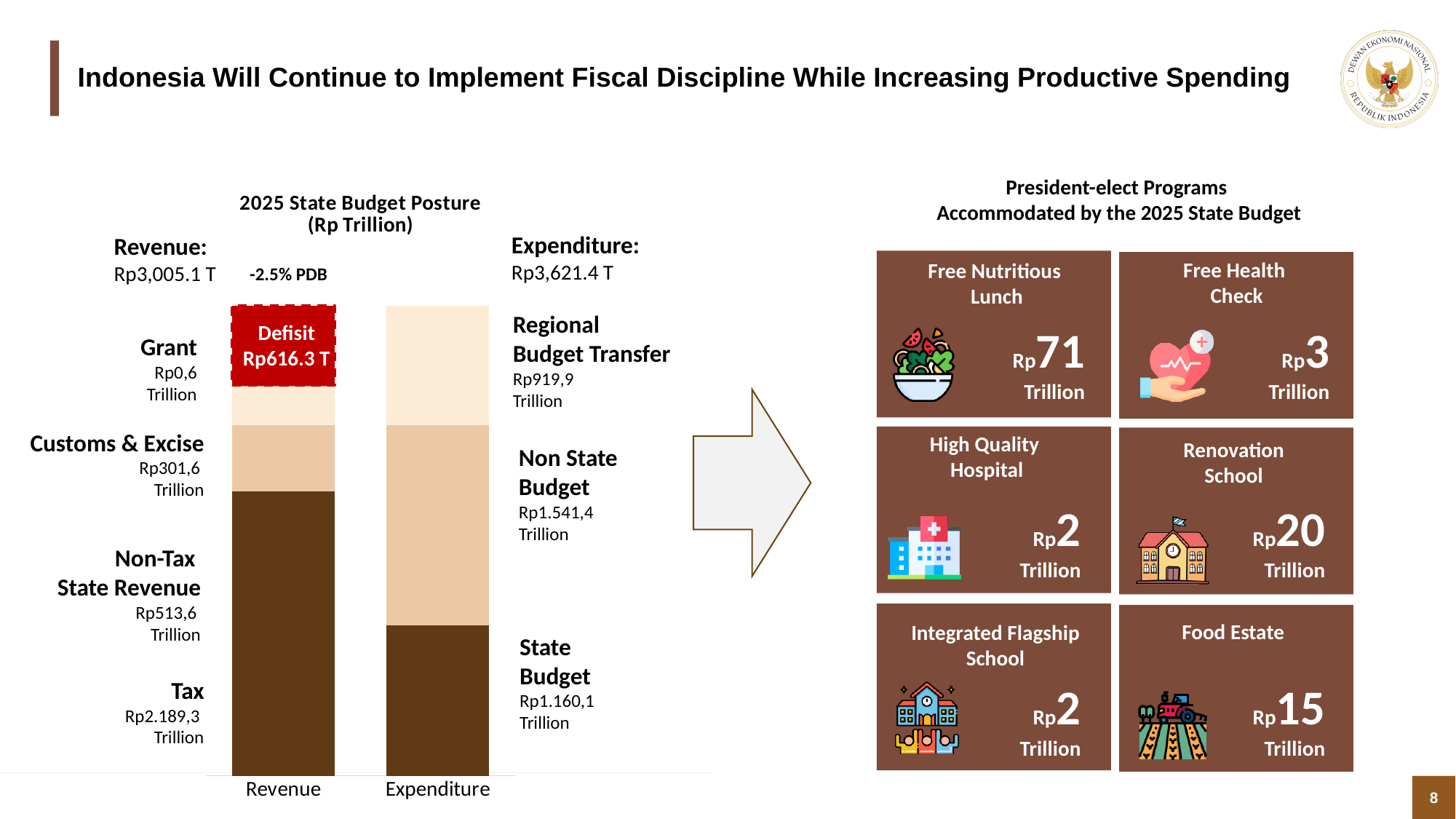
In the 2025 State Budget Posture chart, what is the total of the Expenditure bar? Rp3,621.4 T What kind of chart is the 2025 State Budget Posture chart? Stacked bar chart In the 2025 State Budget Posture chart, which segment of the Revenue bar is the smallest? Grant In the 2025 State Budget Posture chart, what is the value of the Non State Budget segment of the Expenditure bar? Rp1.541,4 Trillion How many bars are shown in the 2025 State Budget Posture chart? 2 In the 2025 State Budget Posture chart, which segment of the Revenue bar is the largest? Tax In the 2025 State Budget Posture chart, what is the value of the Customs & Excise segment? Rp301,6 Trillion In the 2025 State Budget Posture chart, what is the value of the Tax segment of the Revenue bar? Rp2.189,3 Trillion In the 2025 State Budget Posture chart, what is the value of the Regional Budget Transfer segment? Rp919,9 Trillion What is the title of the bar chart on the left of the slide? 2025 State Budget Posture (Rp Trillion) In the 2025 State Budget Posture chart, what is the deficit shown between Expenditure and Revenue? Rp616.3 T